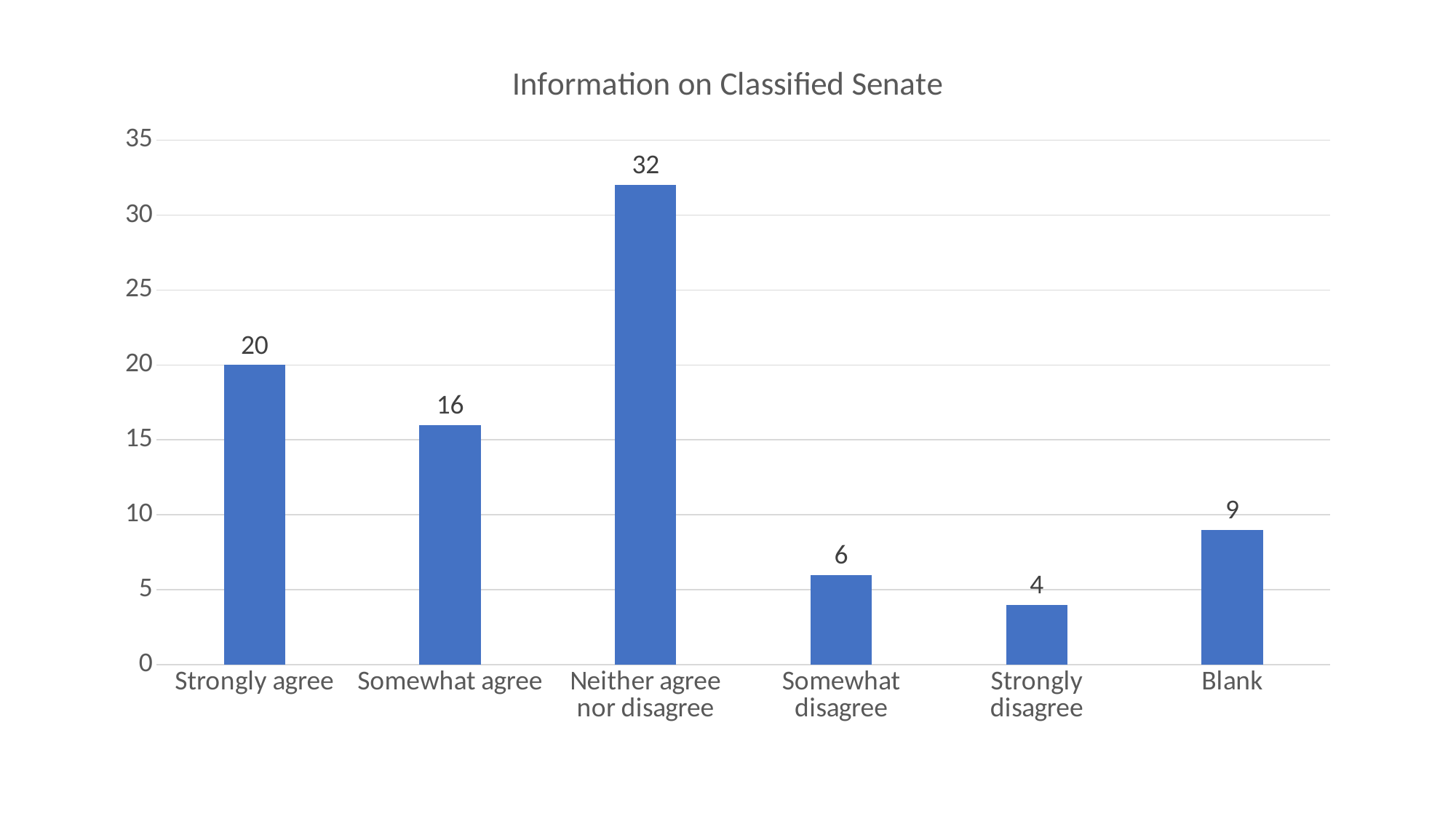
What is the title of the chart? Information on Classified Senate How many categories are shown on the x axis? 6 Is the value for Somewhat agree greater or less than 15? greater What is the difference between the values for Neither agree nor disagree and Blank? 23 What is the value for Neither agree nor disagree? 32 What is the value for Strongly agree? 20 Which is larger, the value for Somewhat disagree or the value for Blank? Blank Which category has the lowest value? Strongly disagree What kind of chart is this? bar chart What is the value for Blank? 9 What is the difference between the values for Strongly agree and Somewhat agree? 4 Which category has the highest value? Neither agree nor disagree